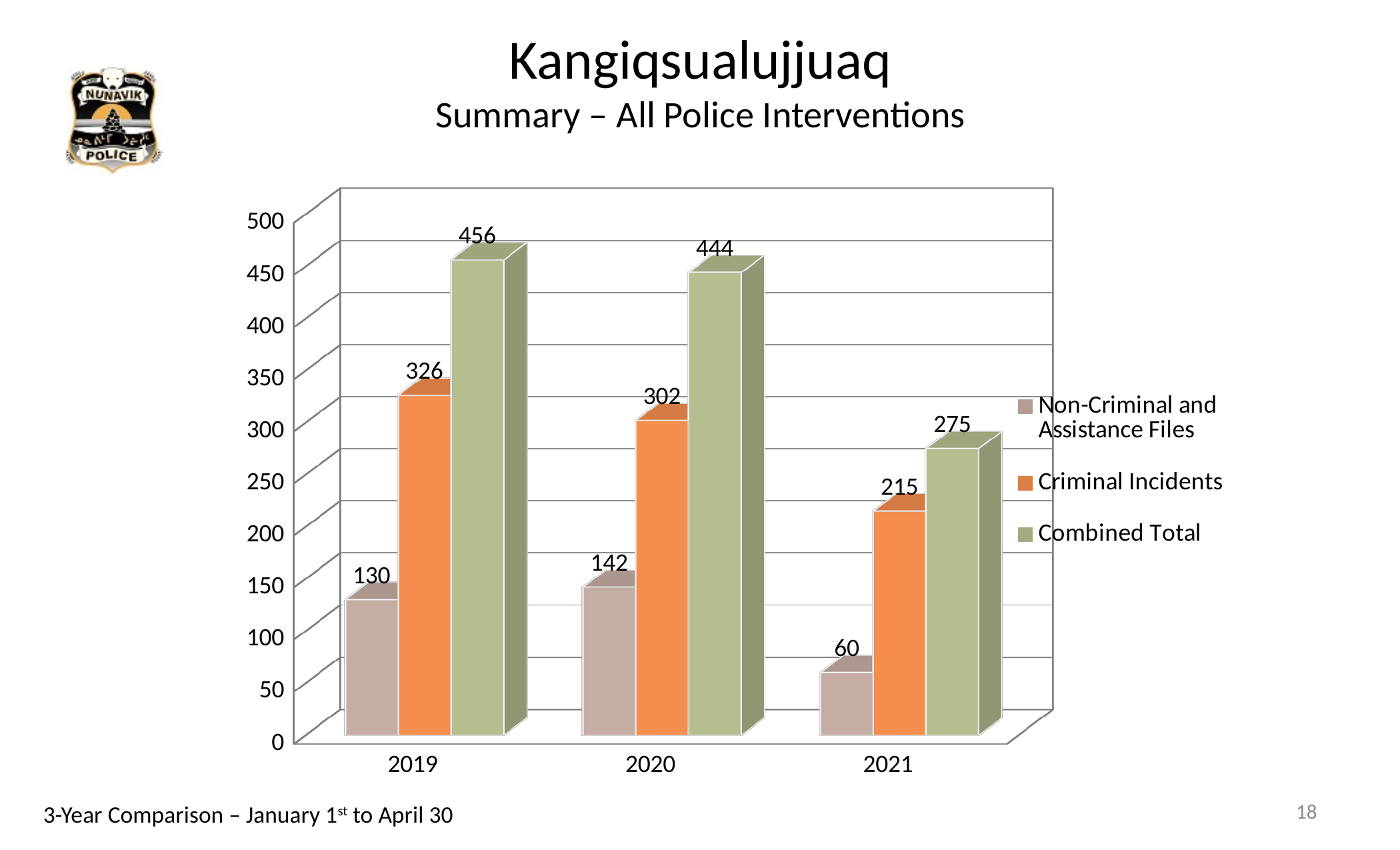
How many series does the legend list? 3 Do the Combined Total values rise or fall from 2019 to 2021? Fall What is the value for Non-Criminal and Assistance Files in 2021? 60 Which year has the lowest value for Criminal Incidents? 2021 What is the difference between Criminal Incidents in 2019 and in 2020? 24 What is the Combined Total for 2019? 456 How many years are shown on the x axis? 3 Which year has the highest Combined Total? 2019 What kind of chart is shown on the slide? Bar chart What is the value for Criminal Incidents in 2020? 302 What is the difference between the Combined Total in 2019 and in 2021? 181 Which is larger: Non-Criminal and Assistance Files in 2019 or in 2020? 2020